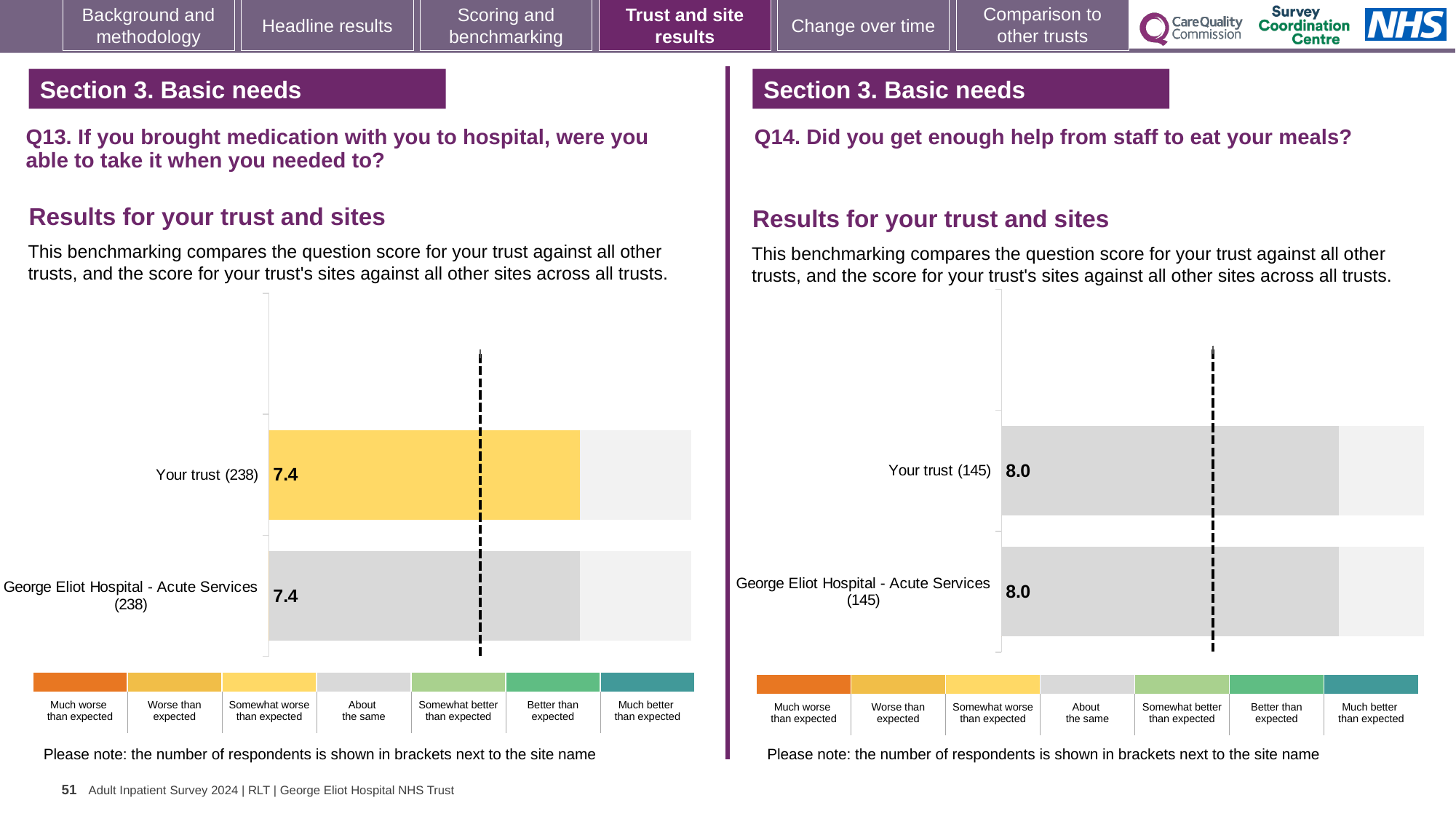
In the Q13 chart on the left, what is the score for George Eliot Hospital - Acute Services? 7.4 In the Q14 chart on the right, what is the difference between the score for Your trust and the score for George Eliot Hospital - Acute Services? 0.0 In the Q13 chart on the left, how many respondents are shown in brackets for Your trust? 238 In the Q14 chart on the right, what is the score for George Eliot Hospital - Acute Services? 8.0 How many bars are plotted in the Q14 chart on the right? 2 How many bars are plotted in the Q13 chart on the left? 2 In the Q13 chart on the left, what is the difference between the score for Your trust and the score for George Eliot Hospital - Acute Services? 0.0 In the Q13 chart on the left, which benchmark category does the colour of the Your trust bar correspond to in the key? Somewhat worse than expected In the Q14 chart on the right, how many respondents are shown in brackets for George Eliot Hospital - Acute Services? 145 What type of chart is used for the Q13 results on the left? Bar chart In the Q13 chart on the left, what is the score for Your trust? 7.4 In the Q14 chart on the right, what is the score for Your trust? 8.0